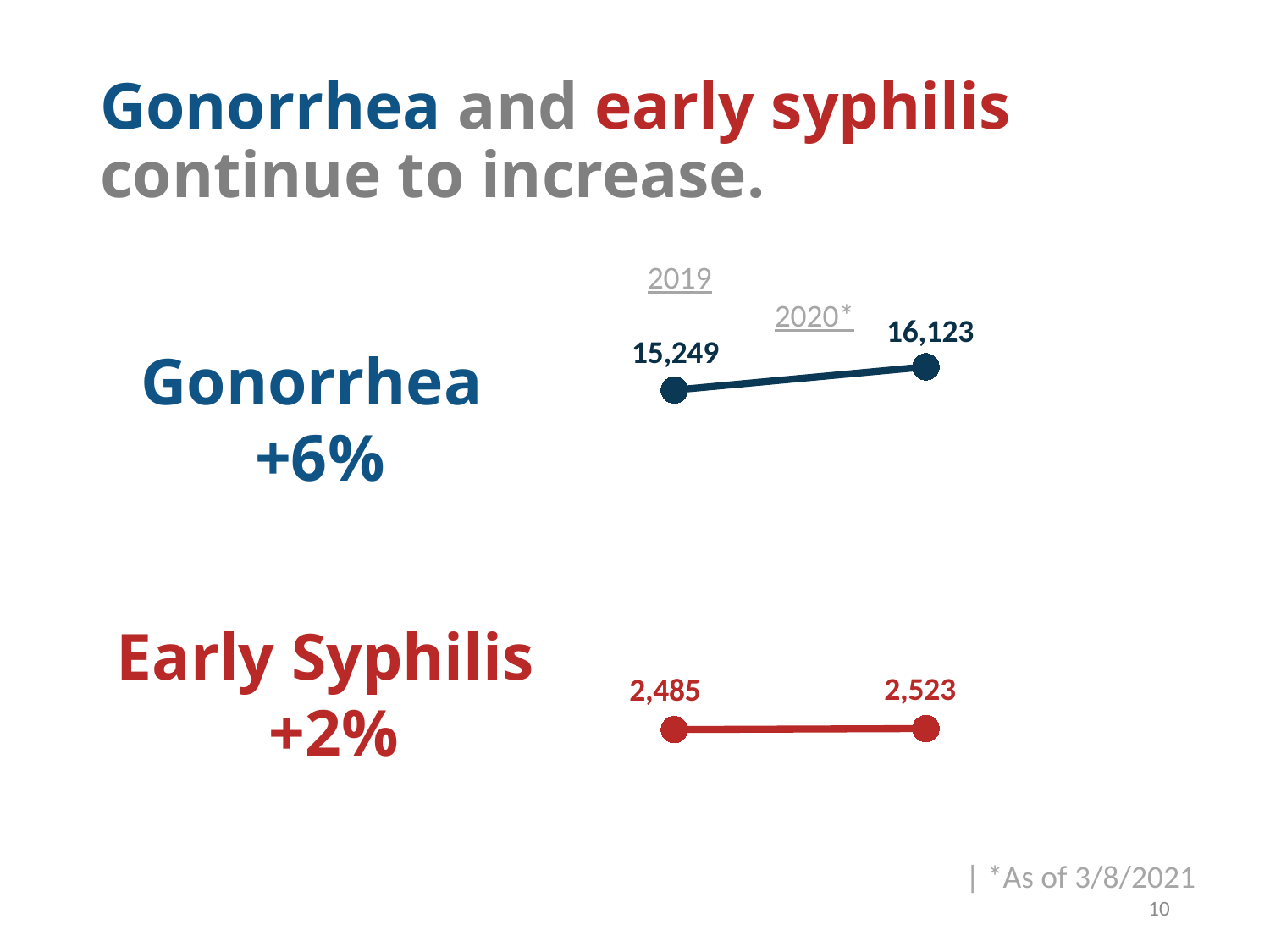
In the Gonorrhea chart, do the values rise or fall from 2019 to 2020*? rise In the Early Syphilis chart, what is the value for 2020*? 2,523 What kind of chart is used for Early Syphilis? line chart In the Gonorrhea chart, what is the value for 2019? 15,249 In the Early Syphilis chart, which year has the lower value? 2019 In the Early Syphilis chart, what is the value for 2019? 2,485 What colour is the line in the Early Syphilis chart? red In the Gonorrhea chart, which year has the higher value, 2019 or 2020*? 2020* In the Early Syphilis chart, what is the difference between the 2020* and 2019 values? 38 In the Gonorrhea chart, what is the value for 2020*? 16,123 How many data points are plotted in the Gonorrhea chart? 2 In the Gonorrhea chart, what is the difference between the 2020* and 2019 values? 874